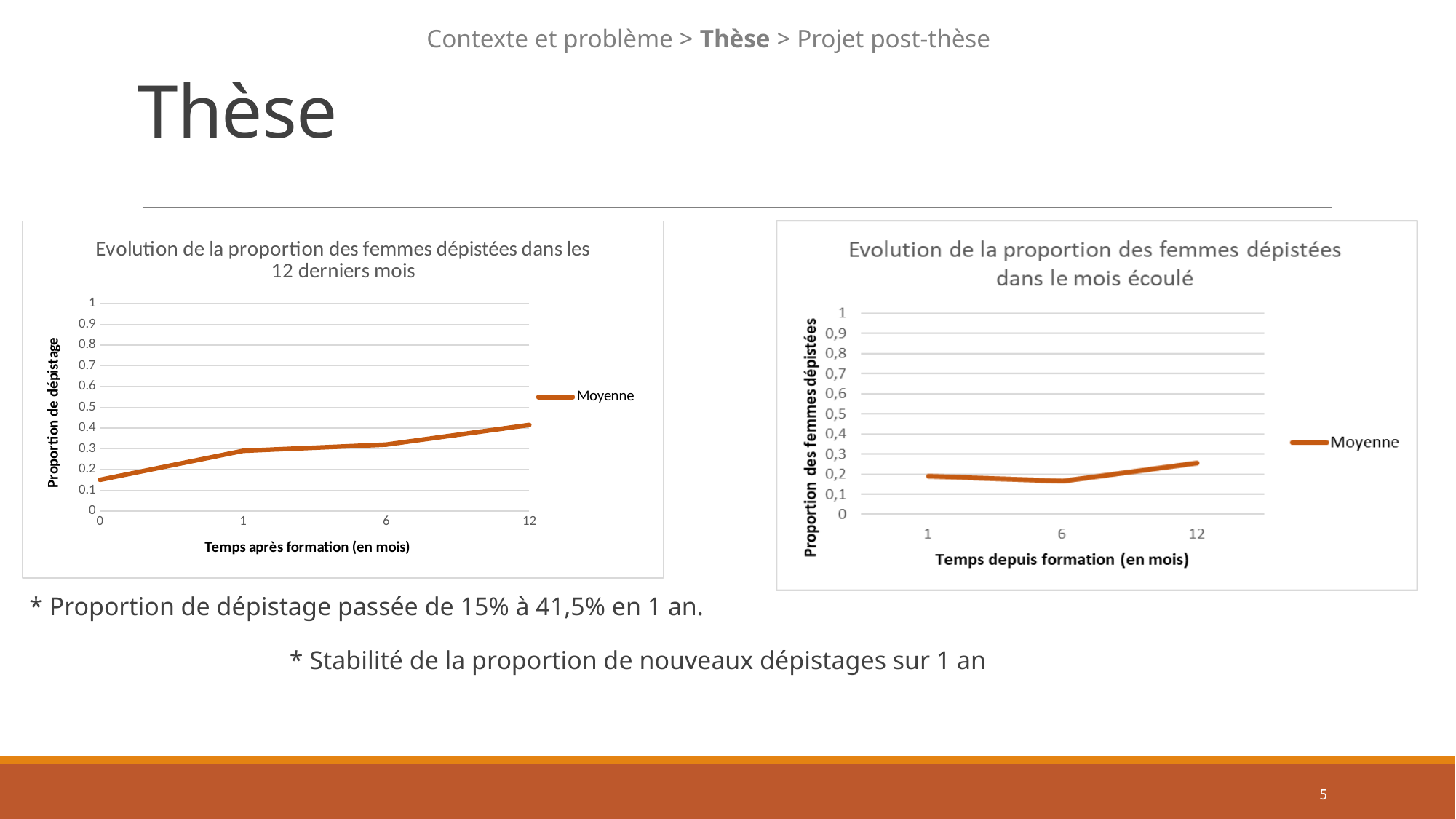
In the left chart, is the value at 12 months greater or less than 0.3? greater How many series does the legend of the left chart list? 1 In the right chart, how many time points are plotted along the x axis? 3 What kind of chart is the right chart, 'Evolution de la proportion des femmes dépistées dans le mois écoulé'? Line chart What is the x-axis label of the right chart? Temps depuis formation (en mois) What kind of chart is the left chart, 'Evolution de la proportion des femmes dépistées dans les 12 derniers mois'? Line chart In the left chart, how many time points are plotted along the x axis? 4 In the left chart, does the proportion rise or fall from 0 to 12 months after training? Rise In the left chart, at which time point is the proportion highest? 12 In the right chart, is the value at 6 months greater or less than 0.2? less In the right chart, which is larger: the value at 1 month or the value at 12 months? 12 months In the left chart, at which time point is the proportion lowest? 0